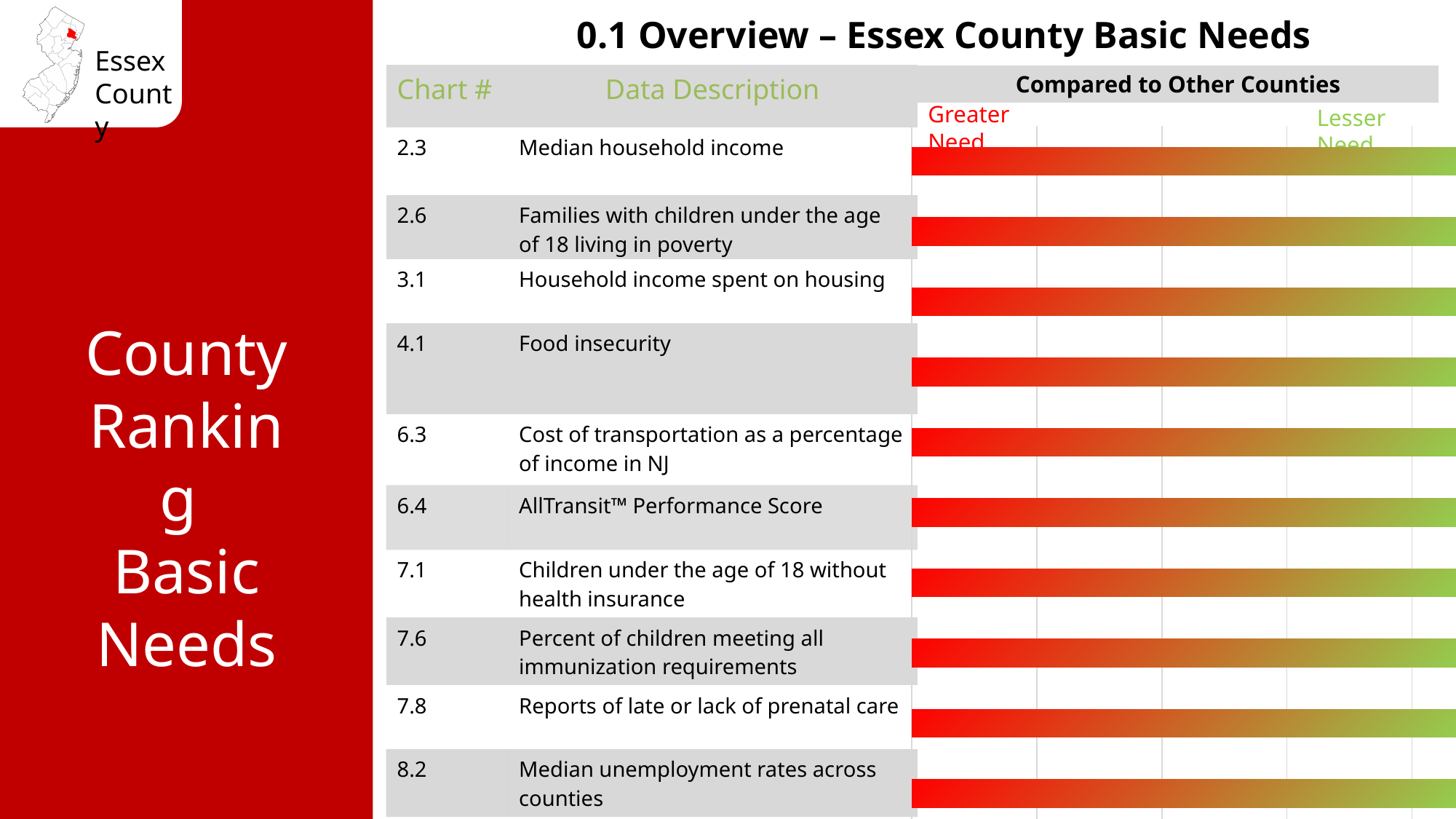
What kind of chart is shown on the slide? bar chart Which data description is listed for chart number 8.2? Median unemployment rates across counties What chart number is listed for "Median household income"? 2.3 What chart number is listed for "Reports of late or lack of prenatal care"? 7.8 What label appears at the left (red) end of the bars? Greater Need Which data description is listed for chart number 6.4? AllTransit™ Performance Score What is the title of the slide? 0.1 Overview – Essex County Basic Needs How many data description rows (bars) are shown in the chart? 10 What chart number is listed for "Food insecurity"? 4.1